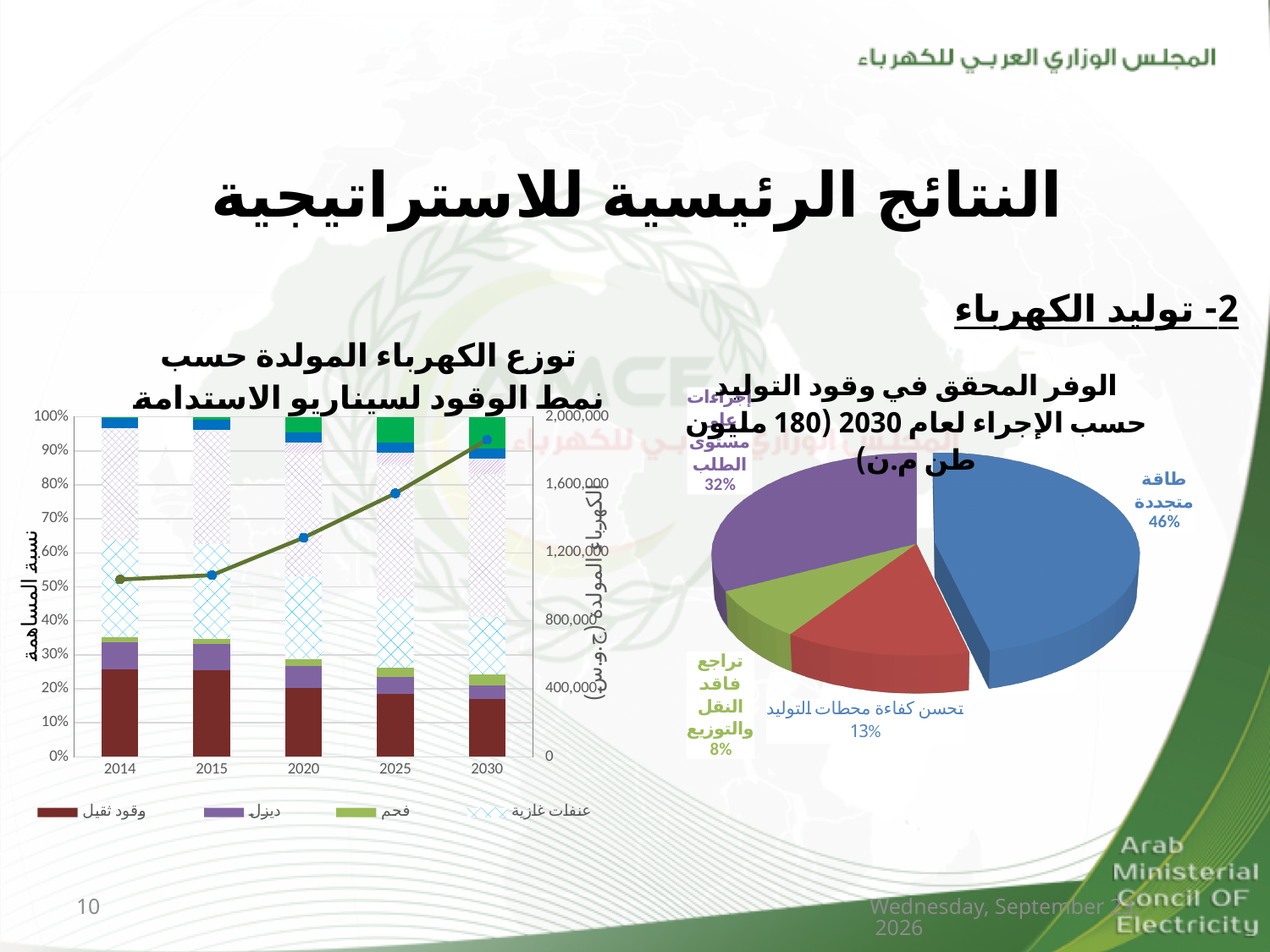
In the bar chart on the left, does the line for total generated electricity rise or fall from 2014 to 2030? Rises In the pie chart on the right, which measure has the largest share of the fuel savings? طاقة متجددة In the pie chart on the right, what share is attributed to طاقة متجددة? 46% In the pie chart on the right, which is larger: the share for إجراءات على مستوى الطلب or the share for تحسن كفاءة محطات التوليد? إجراءات على مستوى الطلب In the bar chart on the left, is the share of وقود ثقيل in 2030 greater or less than 20%? less What kind of chart is the chart on the right of the slide? Pie chart In the bar chart on the left, is the line value for 2030 greater or less than 1,600,000 on the right axis? greater In the pie chart on the right, what share is attributed to تراجع فاقد النقل والتوزيع? 8% In the bar chart on the left, how many years are shown on the x axis? 5 In the pie chart on the right, which measure has the smallest share of the fuel savings? تراجع فاقد النقل والتوزيع In the pie chart on the right, how many percentage points larger is the share of طاقة متجددة than the share of تحسن كفاءة محطات التوليد? 33 percentage points In the pie chart on the right, what share is attributed to تحسن كفاءة محطات التوليد? 13%